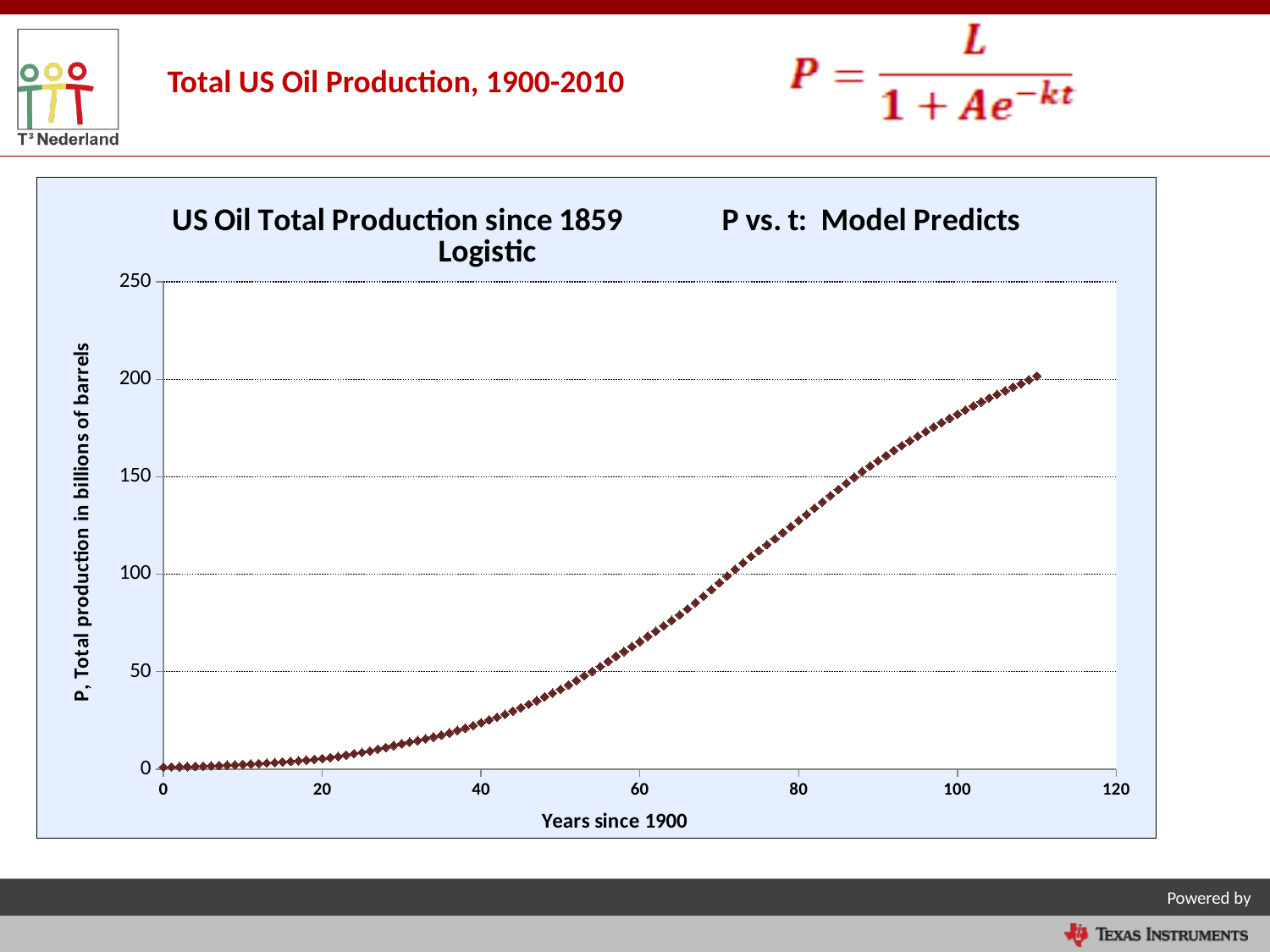
Is the value for 80 years since 1900 greater or less than 100? greater What kind of chart is shown on the slide? scatter chart Do the plotted values rise or fall as years since 1900 increase? rise What is the title of the y axis? P, Total production in billions of barrels Is the value for 60 years since 1900 greater or less than 50? greater Is the value for 60 years since 1900 greater or less than 100? less Which has the larger value, 40 years since 1900 or 80 years since 1900? 80 years since 1900 What is the title of the x axis? Years since 1900